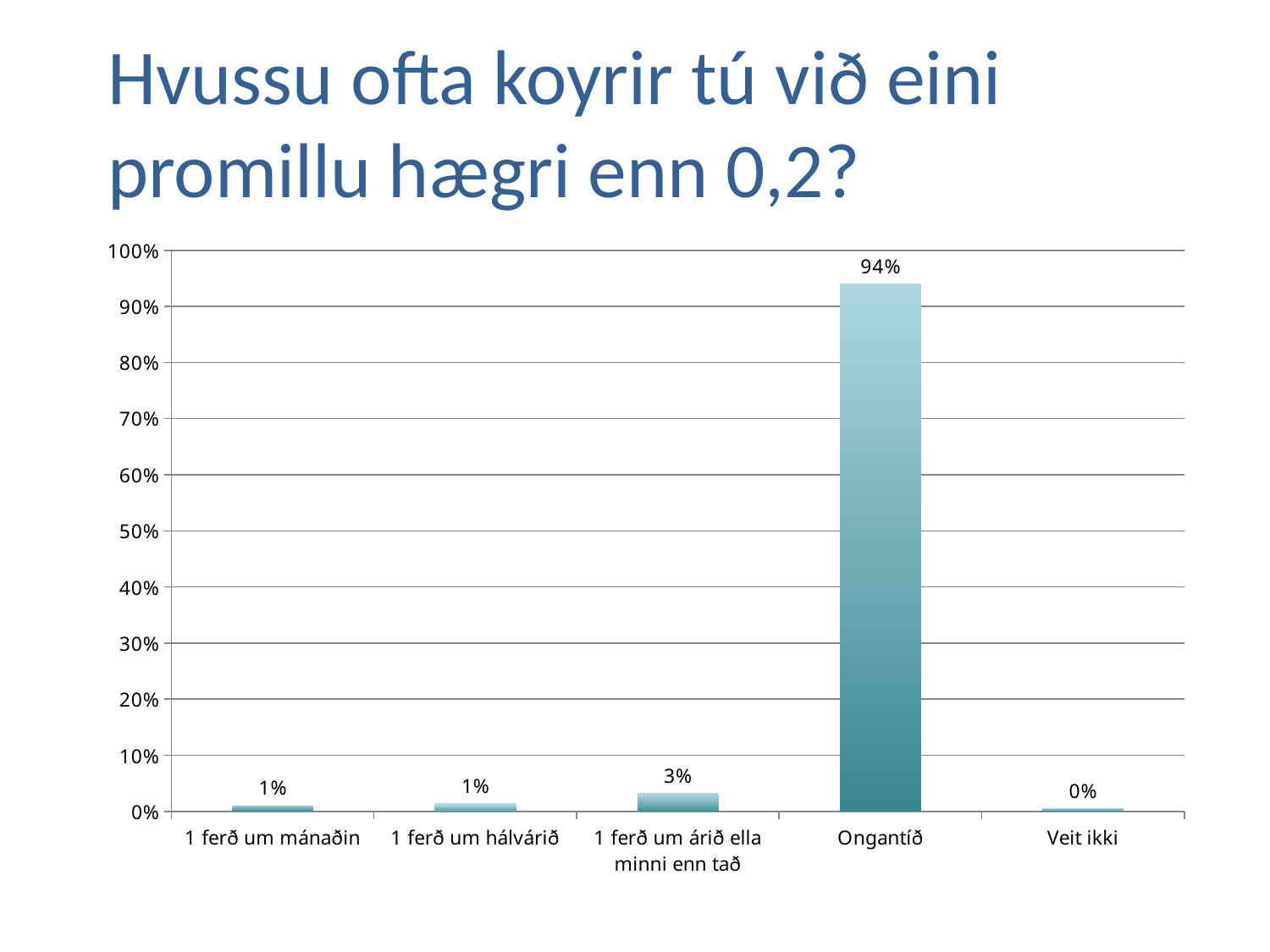
How many categories are shown on the x axis? 5 Which category has the lowest value? Veit ikki What is the value for Ongantíð? 94% What kind of chart is shown on the slide? bar chart What is the value for Veit ikki? 0% Which category has the highest value? Ongantíð Is the value for Ongantíð greater or less than 90%? greater What is the title of the slide? Hvussu ofta koyrir tú við eini promillu hægri enn 0,2? What is the value for 1 ferð um mánaðin? 1% What is the difference between the values for Ongantíð and 1 ferð um árið ella minni enn tað? 91% Which is larger, the value for 1 ferð um árið ella minni enn tað or the value for 1 ferð um hálvárið? 1 ferð um árið ella minni enn tað What is the value for 1 ferð um árið ella minni enn tað? 3%